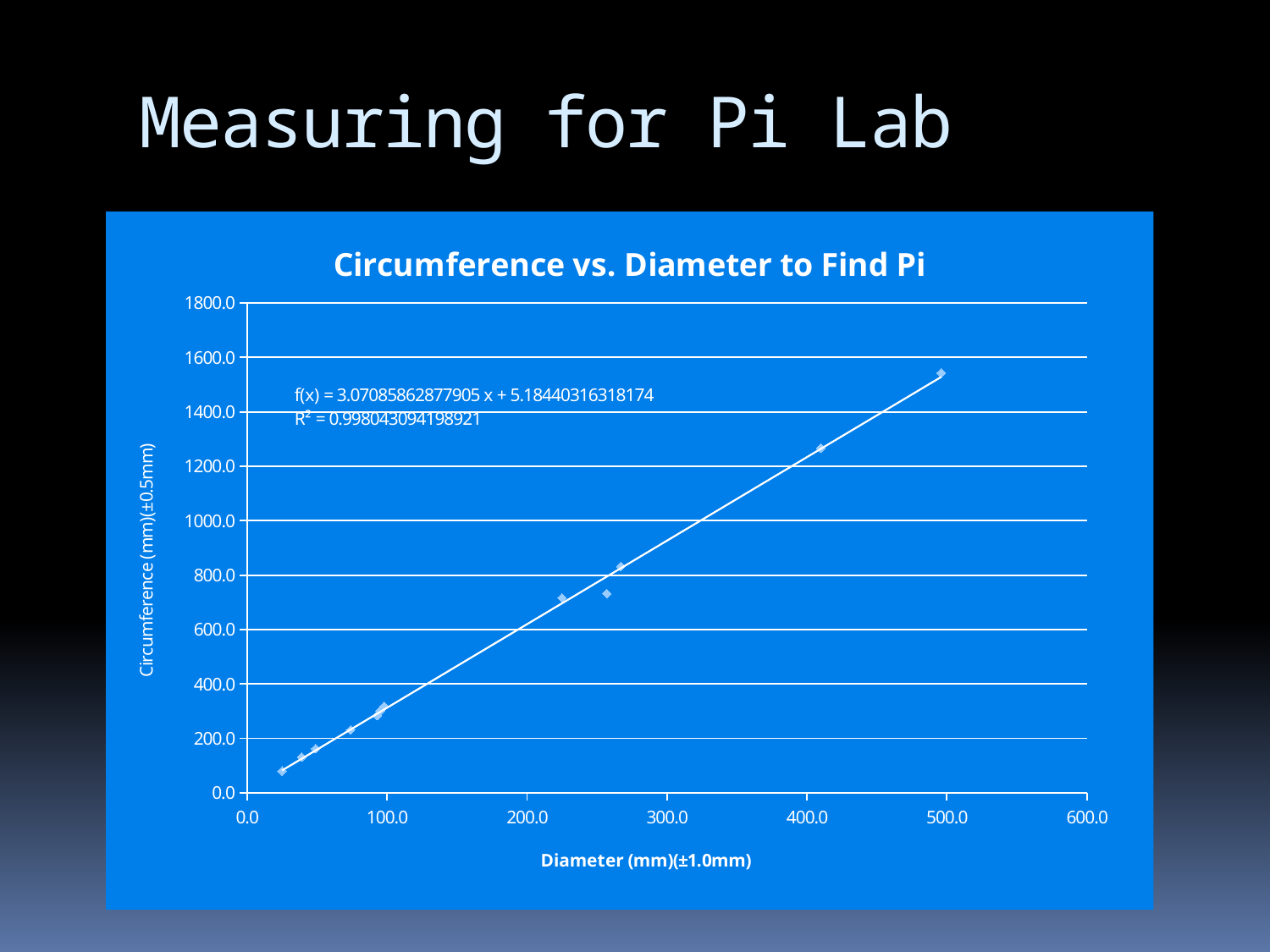
Is the largest diameter plotted greater or less than 400? greater Is the circumference of the point plotted near a diameter of 410 mm greater or less than 1200? greater Is the circumference of the point plotted near a diameter of 75 mm greater or less than 400? less Which plotted point has the highest circumference? The point with the largest diameter (near 500 mm) What is the slope of the fitted line shown in the equation on the chart? 3.07085862877905 What R² value is shown on the chart? 0.998043094198921 Which has the larger circumference: the point near a diameter of 410 mm or the point near a diameter of 265 mm? The point near 410 mm As diameter increases along the x axis, does circumference rise or fall? Rise What kind of chart is shown on the slide? Scatter chart